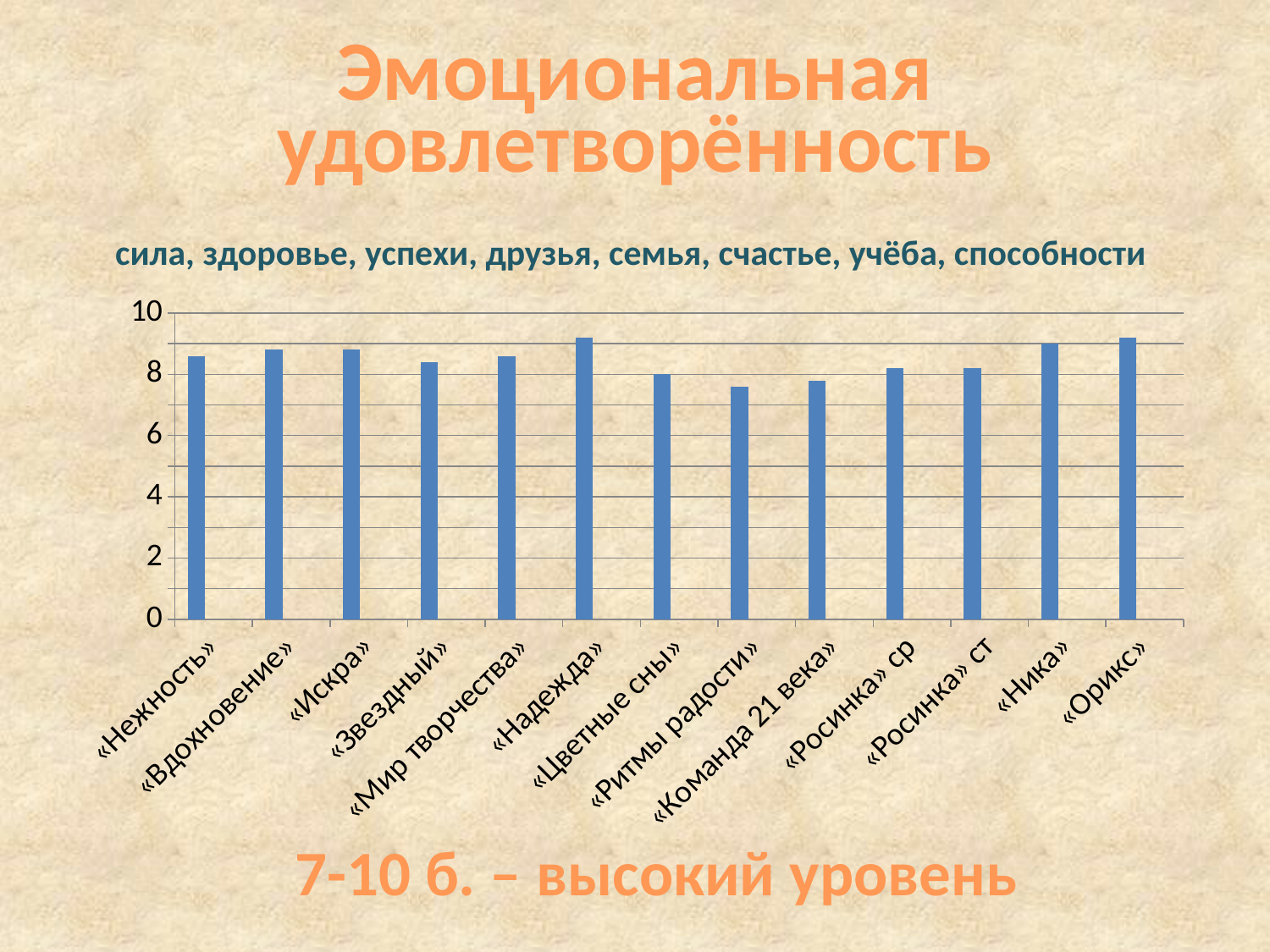
Is the value for «Надежда» greater or less than 8? greater Which has the larger value, «Надежда» or «Ритмы радости»? «Надежда» What kind of chart is shown on the slide? bar chart Is the value for «Орикс» greater or less than 8? greater What is the title printed above the chart? сила, здоровье, успехи, друзья, семья, счастье, учёба, способности Which has the larger value, «Ника» or «Звездный»? «Ника» What is the highest value shown on the chart's vertical axis? 10 Is the value for «Ритмы радости» greater or less than 8? less Which has the larger value, «Орикс» or «Команда 21 века»? «Орикс» How many categories (groups) are shown on the x axis of the chart? 13